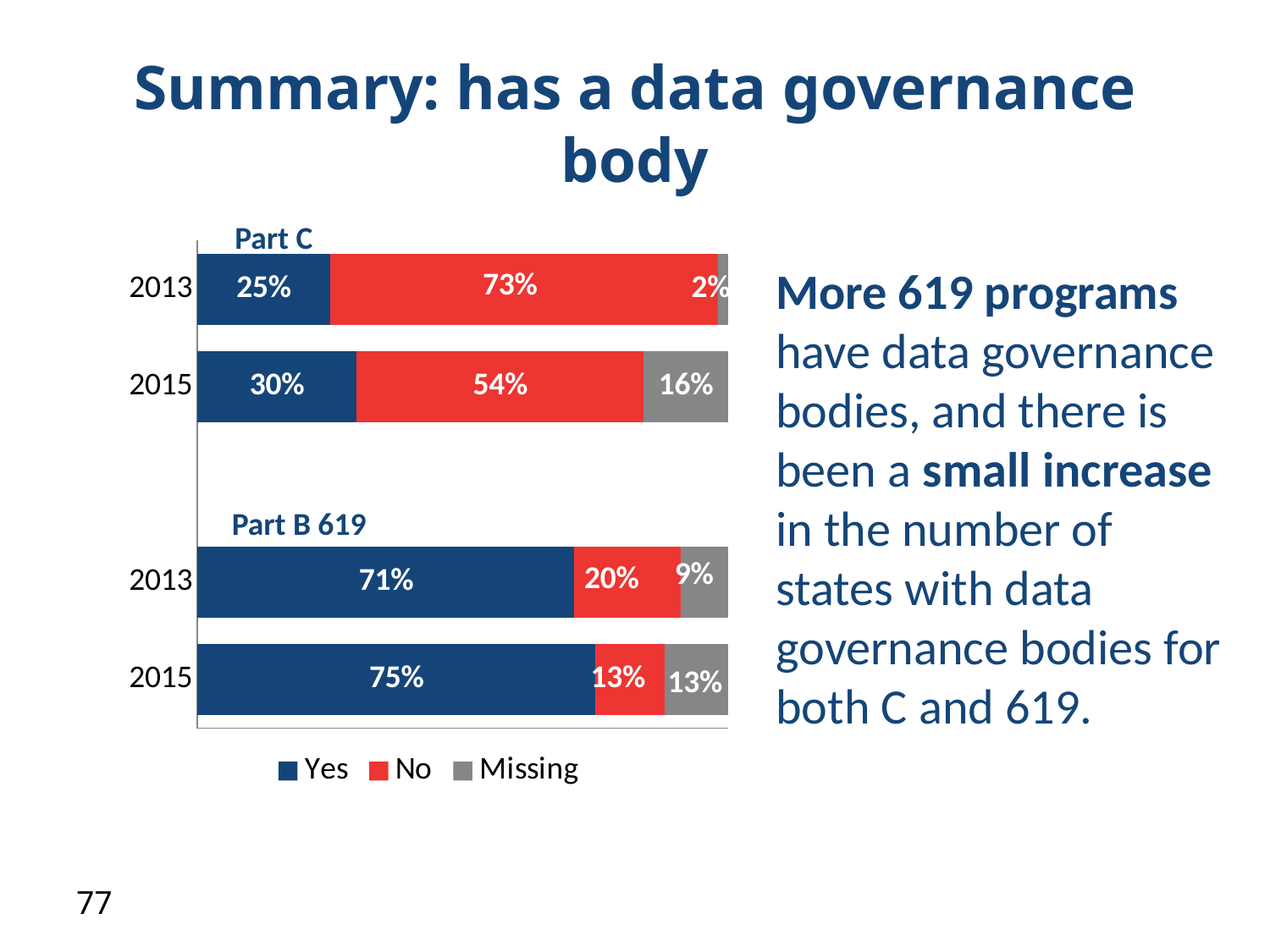
How many series does the legend list? 3 What percentage of Part C programs answered No in 2015? 54% Which colour represents the No responses in the chart? Red What kind of chart is shown on the slide? Stacked bar chart Which is larger: the Yes share for Part C in 2015 or the Yes share for Part B 619 in 2013? Part B 619 in 2013 What percentage of Part B 619 programs answered Yes in 2015? 75% What percentage of Part C programs answered Yes in 2013? 25% Which bar has the lowest Missing percentage? Part C, 2013 Which bar has the highest Yes percentage? Part B 619, 2015 What is the difference between the No share for Part C in 2013 and in 2015? 19 percentage points By how many percentage points did the Part C Yes share increase from 2013 to 2015? 5 percentage points What is the Missing share for Part B 619 in 2013? 9%